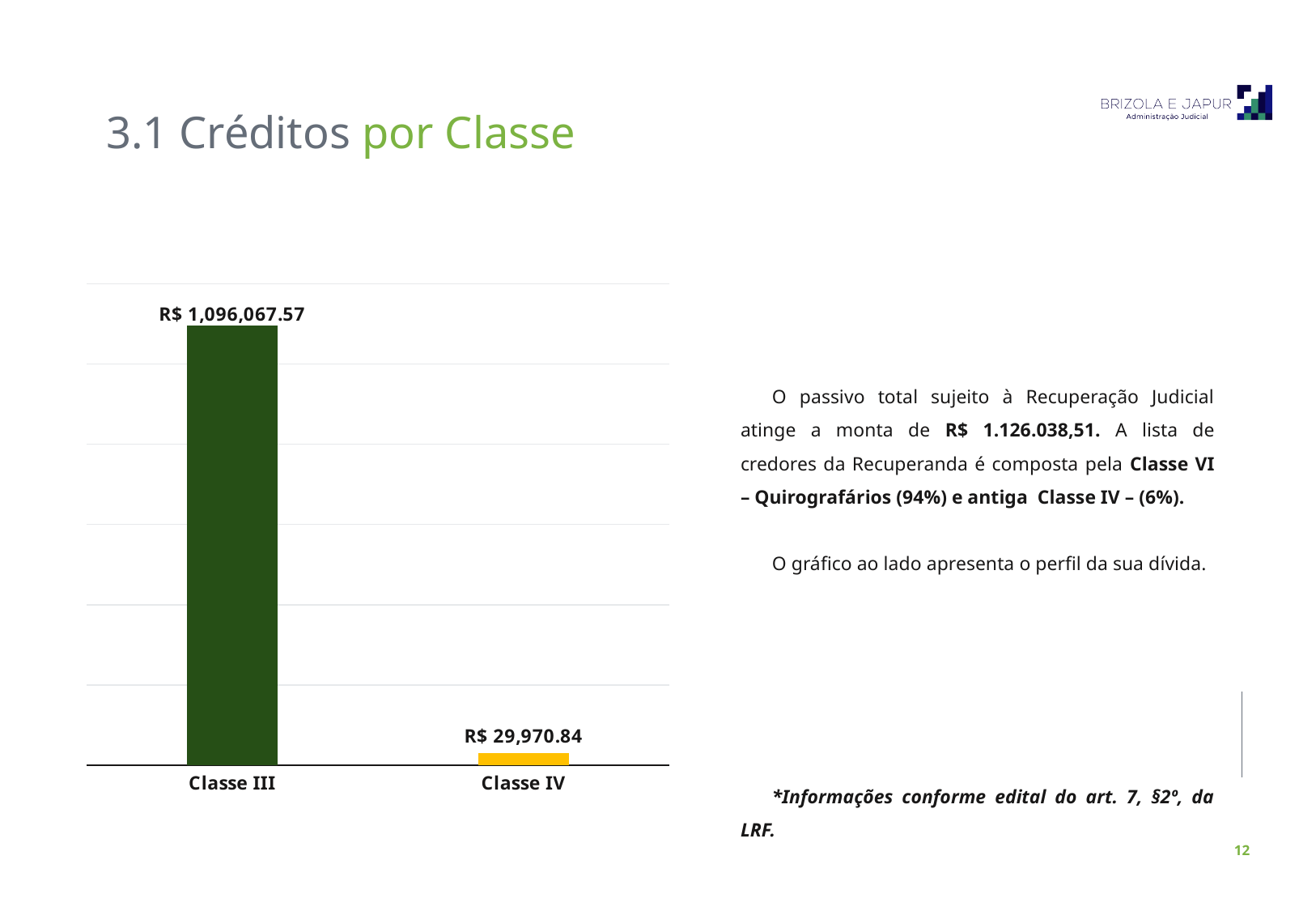
What colour is the bar for Classe III? Dark green What is the value shown for Classe IV? R$ 29,970.84 What is the difference between the values for Classe III and Classe IV? R$ 1,066,096.73 What colour is the bar for Classe IV? Yellow What kind of chart is shown on the slide? Bar chart Which class has the lowest value in the chart? Classe IV What is the value shown for Classe III? R$ 1,096,067.57 How many classes are shown in the chart? 2 Which class has the highest value in the chart? Classe III Which is larger, the value for Classe III or the value for Classe IV? Classe III Do the values rise or fall from Classe III to Classe IV? Fall